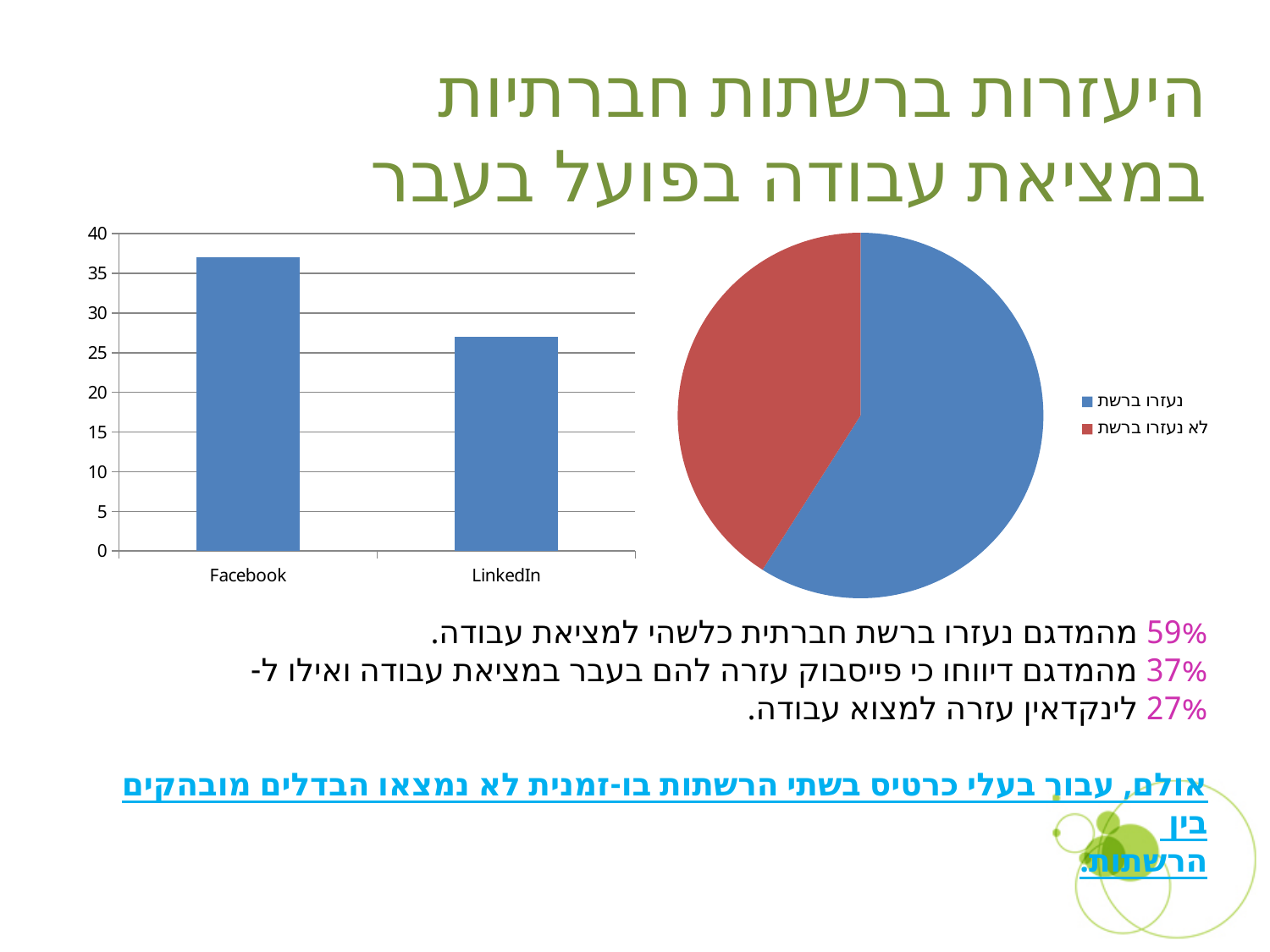
In the bar chart on the left, is the value for LinkedIn greater or less than 25? greater In the bar chart on the left, is the value for LinkedIn greater or less than 30? less In the bar chart on the left, is the value for Facebook greater or less than 35? greater In the pie chart on the right, how many entries does the legend list? 2 In the bar chart on the left, do the values rise or fall from Facebook to LinkedIn? fall In the bar chart on the left, which is larger, the value for Facebook or the value for LinkedIn? Facebook In the pie chart on the right, which slice is larger, נעזרו ברשת or לא נעזרו ברשת? נעזרו ברשת In the bar chart on the left, which category has the lowest value? LinkedIn What kind of chart is the chart on the right of the slide? pie chart What kind of chart is the chart on the left of the slide? bar chart In the bar chart on the left, how many categories are shown on the x axis? 2 In the bar chart on the left, which category has the highest value? Facebook